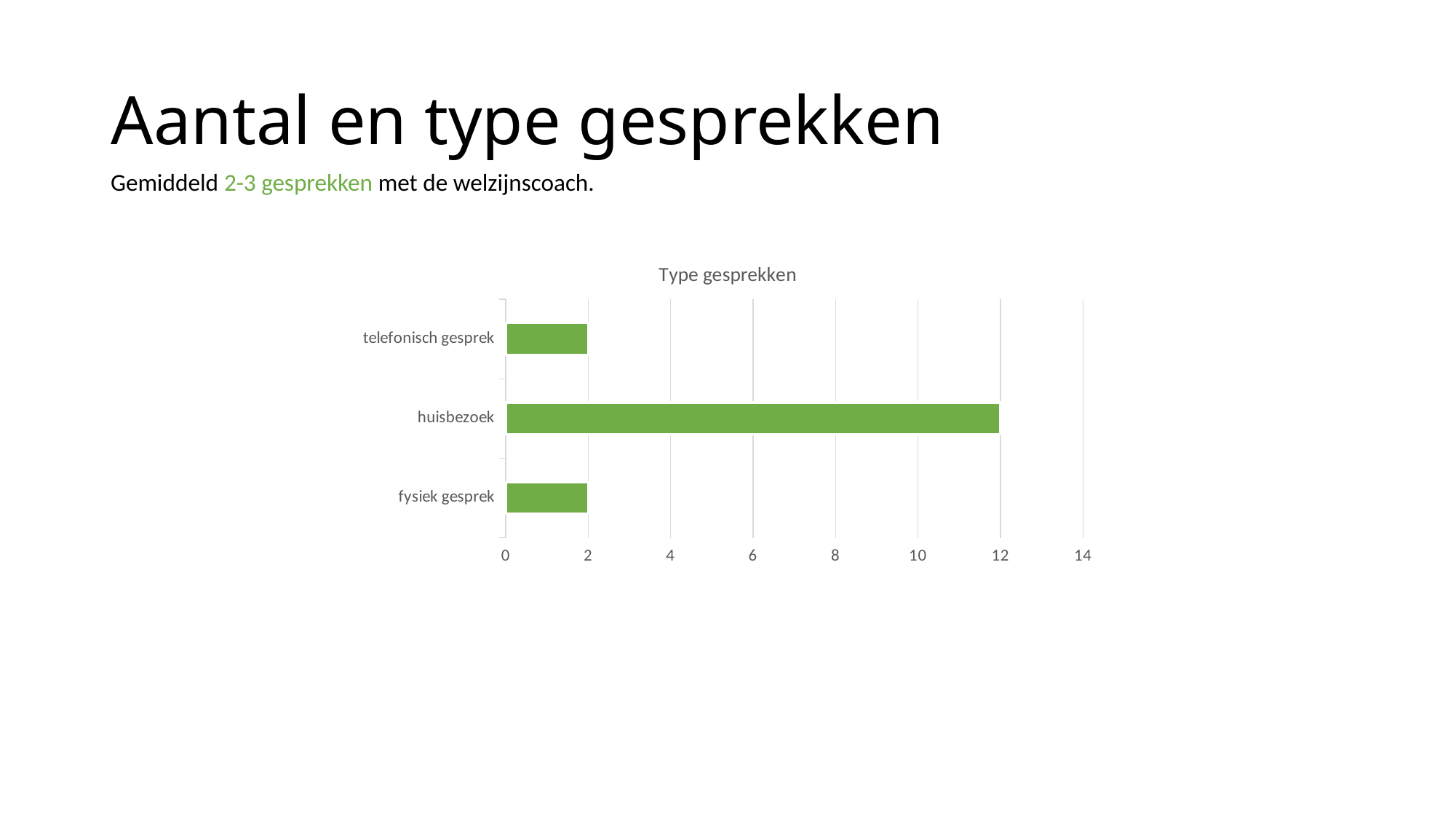
Is the value for telefonisch gesprek greater or less than 4? less What is the value for telefonisch gesprek? 2 What is the difference between the values for huisbezoek and telefonisch gesprek? 10 Which category has the highest value? huisbezoek Which is larger, the value for huisbezoek or the value for fysiek gesprek? huisbezoek What is the highest value shown on the x axis? 14 What is the value for fysiek gesprek? 2 How many categories are shown in the chart? 3 Is the value for huisbezoek greater or less than 10? greater What kind of chart is shown on the slide? bar chart What is the value for huisbezoek? 12 What is the title of the chart? Type gesprekken